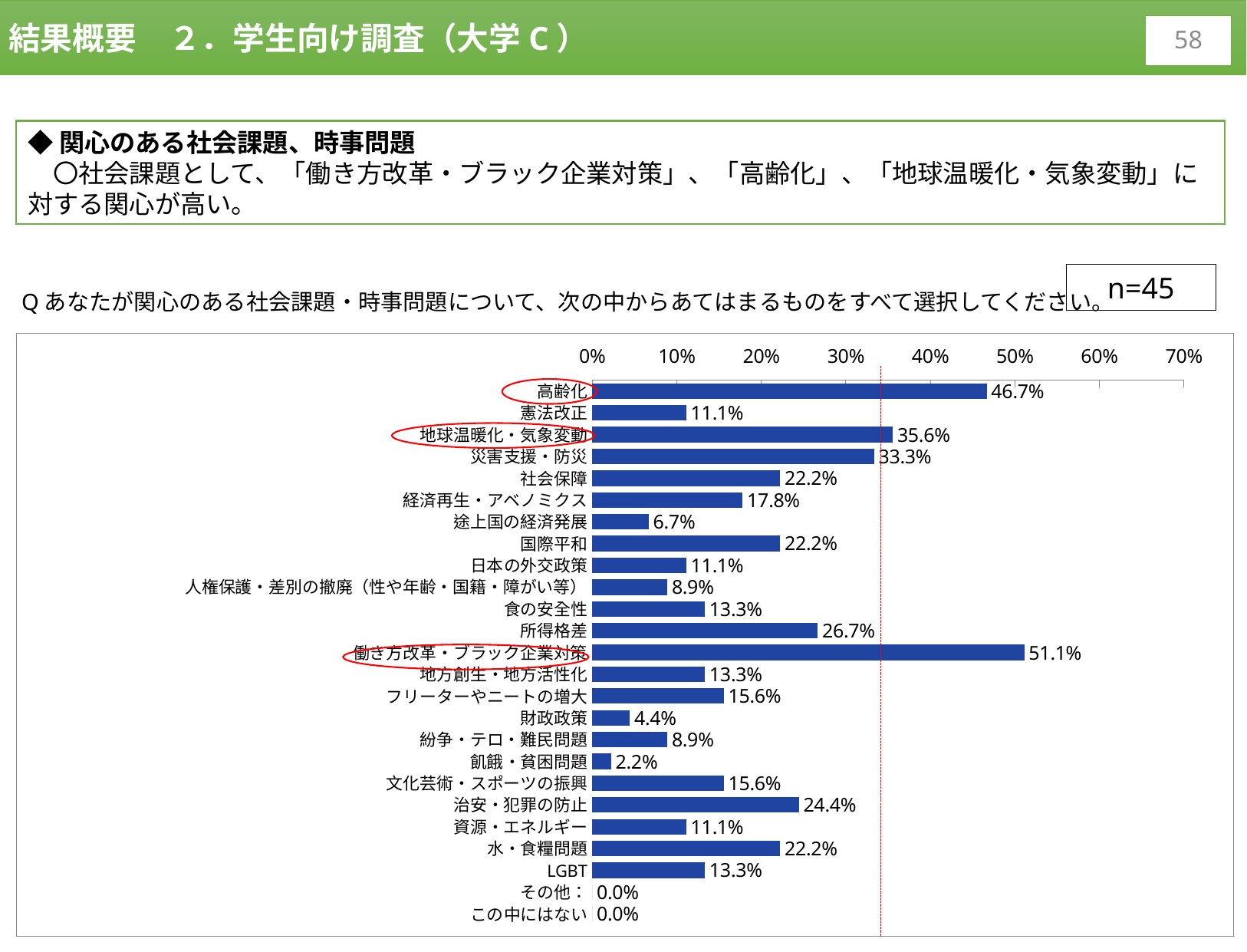
What kind of chart is shown on the slide? bar chart How many categories are shown in the chart? 25 What is the value for 飢餓・貧困問題? 2.2% Which is larger, the value for 地球温暖化・気象変動 or the value for 災害支援・防災? 地球温暖化・気象変動 What is the value for 働き方改革・ブラック企業対策? 51.1% Which category has the highest value? 働き方改革・ブラック企業対策 What is the sample size (n) shown next to the question text? n=45 Is the value for 所得格差 greater or less than 20%? greater What is the difference between the values for 働き方改革・ブラック企業対策 and 高齢化? 4.4% What is the value for 治安・犯罪の防止? 24.4% Among the categories with a non-zero value, which has the lowest value? 飢餓・貧困問題 What is the value for 高齢化? 46.7%